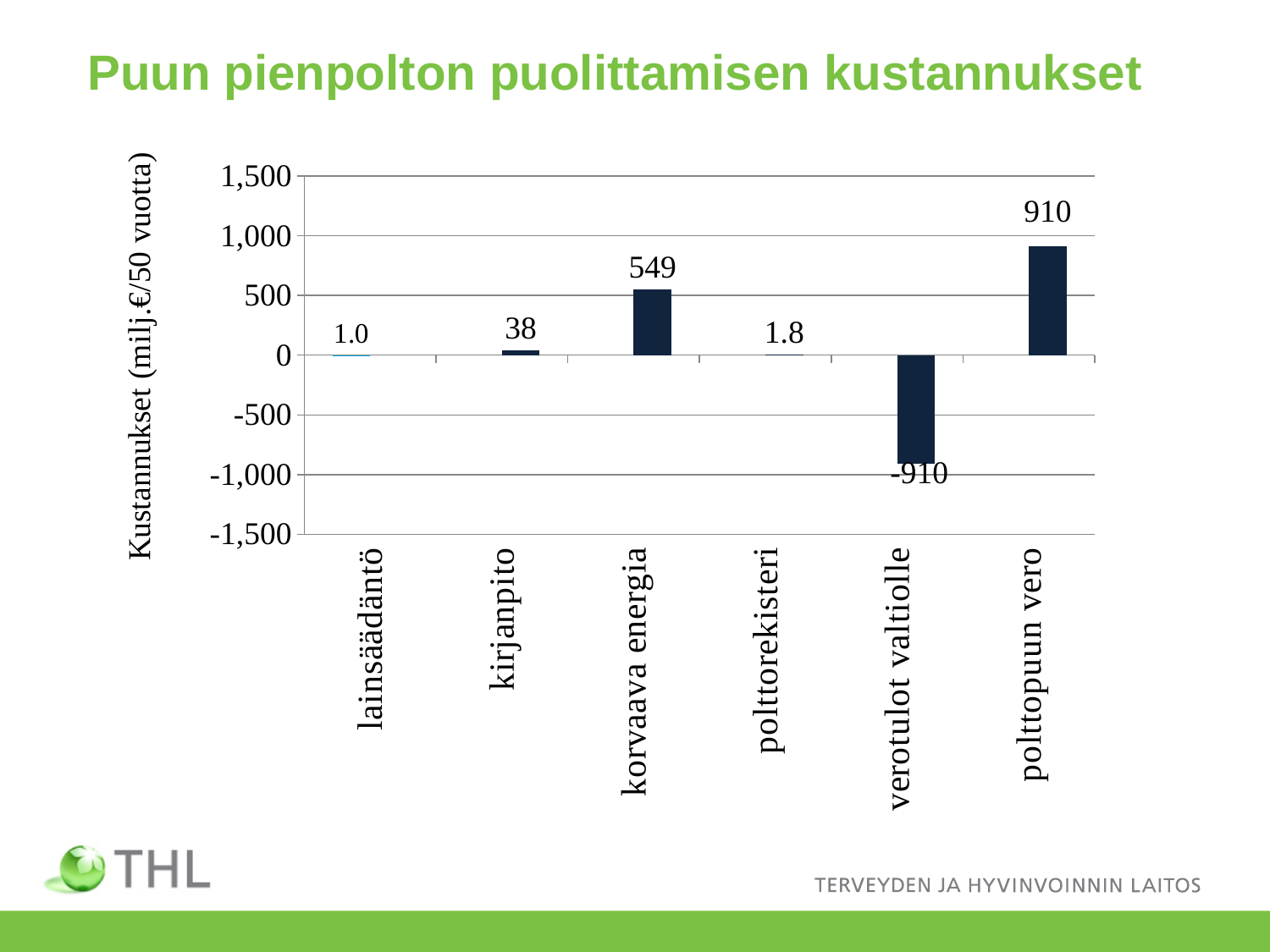
What is the label of the vertical axis? Kustannukset (milj.€/50 vuotta) Which category has the highest value? polttopuun vero What is the value for kirjanpito? 38 How many categories are shown on the x axis? 6 What kind of chart is shown on the slide? bar chart What is the value for lainsäädäntö? 1.0 What is the value for polttorekisteri? 1.8 What is the value for korvaava energia? 549 Which category has the lowest value? verotulot valtiolle What is the value for verotulot valtiolle? -910 Which is larger, the value for kirjanpito or the value for polttorekisteri? kirjanpito What is the difference between the values for polttopuun vero and korvaava energia? 361